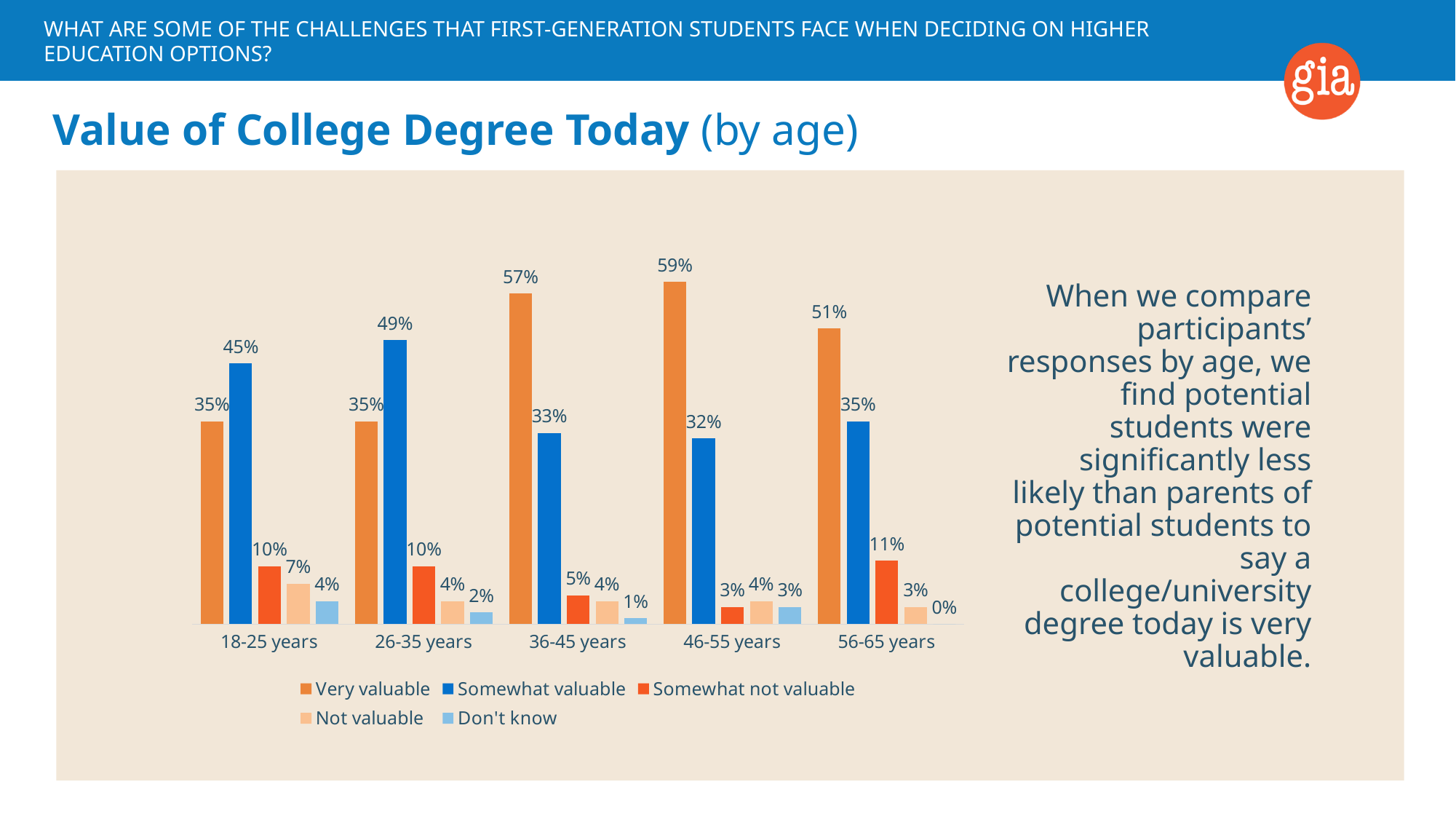
What is the Don't know value for the 18-25 years group? 4% What percentage of 36-45 year olds said a college degree is very valuable? 57% What is the value for Somewhat valuable in the 26-35 years group? 49% What type of chart is shown on the slide? Bar chart How many age groups are shown on the x axis? 5 What is the difference between the Very valuable and Somewhat valuable values for the 36-45 years group? 24% Which age group has the highest Very valuable percentage? 46-55 years What percentage of 56-65 year olds answered Somewhat not valuable? 11% How many series does the legend list? 5 Which age group has the lowest Somewhat valuable percentage? 46-55 years What is the title of the chart? Value of College Degree Today (by age) Which is larger for the 18-25 years group: Very valuable or Somewhat valuable? Somewhat valuable